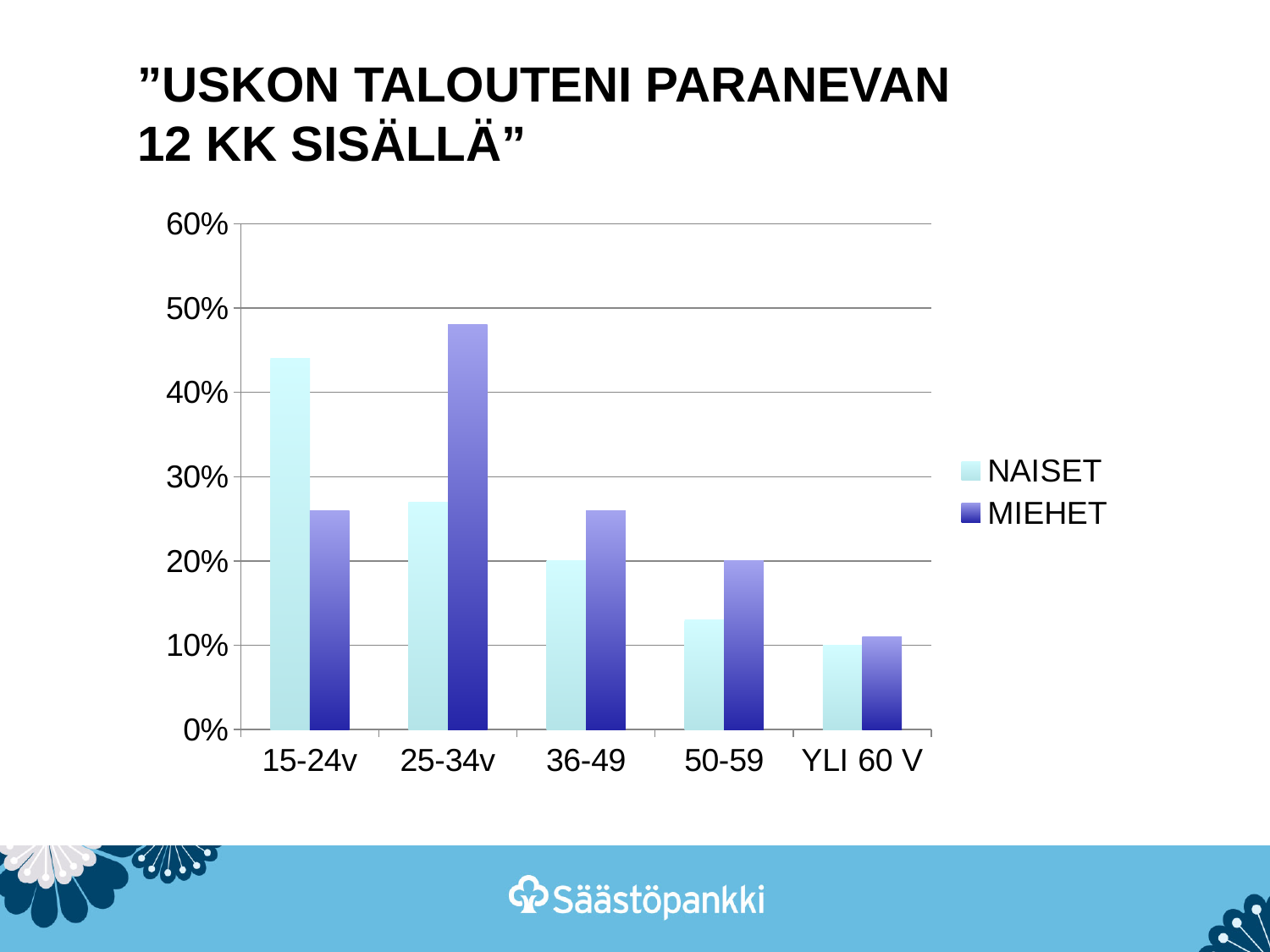
Do the MIEHET values rise or fall from the 25-34v group to the YLI 60 V group? fall Which age group has the lowest value for NAISET? YLI 60 V What kind of chart is shown on the slide? bar chart How many series does the legend list? 2 Which age group has the highest value for NAISET? 15-24v How many age groups are shown on the x axis? 5 In the 15-24v group, which series has the larger value, NAISET or MIEHET? NAISET Is the value for MIEHET in the 25-34v group greater or less than 50%? less Is the value for NAISET in the 15-24v group greater or less than 40%? greater In the 25-34v group, which series has the larger value, NAISET or MIEHET? MIEHET Which age group has the highest value for MIEHET? 25-34v What are the two series named in the legend? NAISET and MIEHET